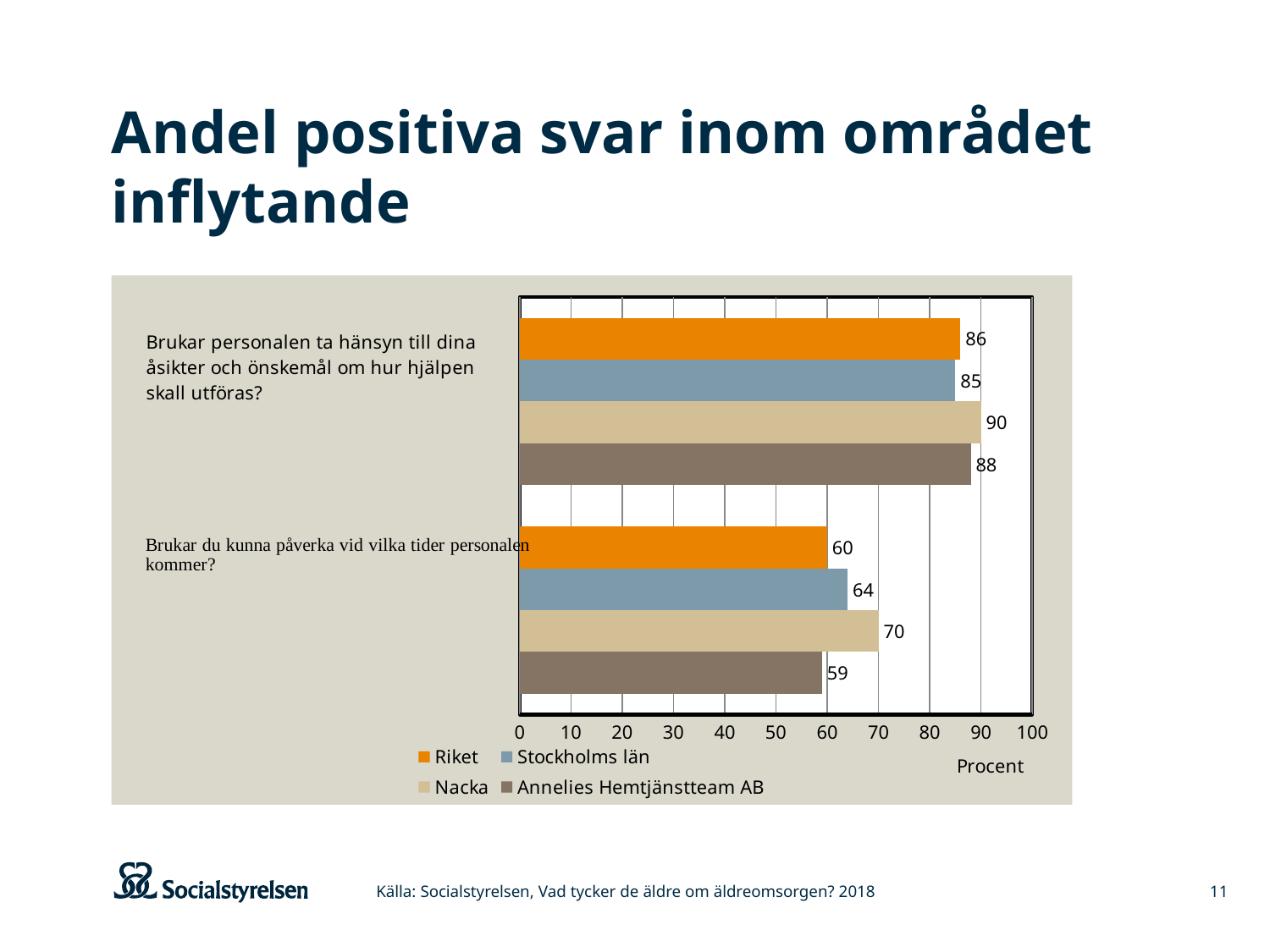
Which series has the lowest value on the question "Brukar du kunna påverka vid vilka tider personalen kommer?"? Annelies Hemtjänstteam AB What is the difference between the Nacka and Riket values on the question "Brukar du kunna påverka vid vilka tider personalen kommer?"? 10 How many series does the legend list? 4 Which is larger on the question "Brukar personalen ta hänsyn till dina åsikter och önskemål om hur hjälpen skall utföras?": Riket or Annelies Hemtjänstteam AB? Annelies Hemtjänstteam AB What kind of chart is shown on the slide? Bar chart What is the value for Riket on the question "Brukar du kunna påverka vid vilka tider personalen kommer?"? 60 What is the label of the horizontal axis? Procent Which series has the highest value on the question "Brukar personalen ta hänsyn till dina åsikter och önskemål om hur hjälpen skall utföras?"? Nacka How many questions (categories) are shown on the chart? 2 What is the value for Nacka on the question "Brukar personalen ta hänsyn till dina åsikter och önskemål om hur hjälpen skall utföras?"? 90 Is the value for Stockholms län on the question "Brukar du kunna påverka vid vilka tider personalen kommer?" greater or less than 70? less What is the value for Annelies Hemtjänstteam AB on the question "Brukar du kunna påverka vid vilka tider personalen kommer?"? 59